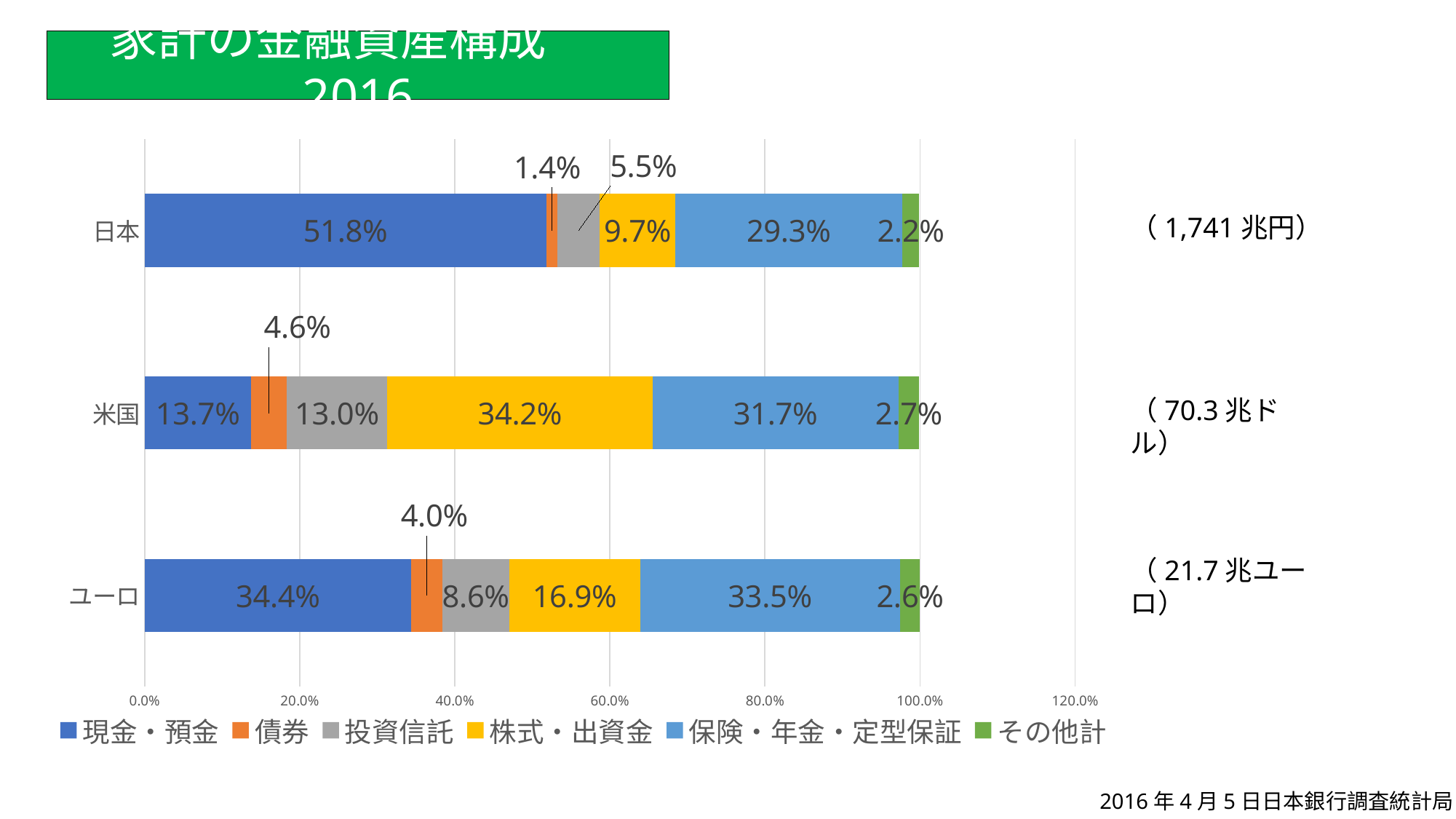
What is the difference between the 現金・預金 share of 日本 and that of 米国? 38.1% Which category has the lowest 株式・出資金 share? 日本 What is the 現金・預金 share for 日本? 51.8% How many categories are shown on the chart? 3 Which is larger, the 保険・年金・定型保証 share for 米国 or for ユーロ? ユーロ What kind of chart is shown on the slide? Stacked bar chart What is the 保険・年金・定型保証 share for ユーロ? 33.5% What is the 株式・出資金 share for 米国? 34.2% How many series does the legend list? 6 What is the 債券 share for 日本? 1.4% What is the 投資信託 share for 米国? 13.0% Which category has the highest 現金・預金 share? 日本